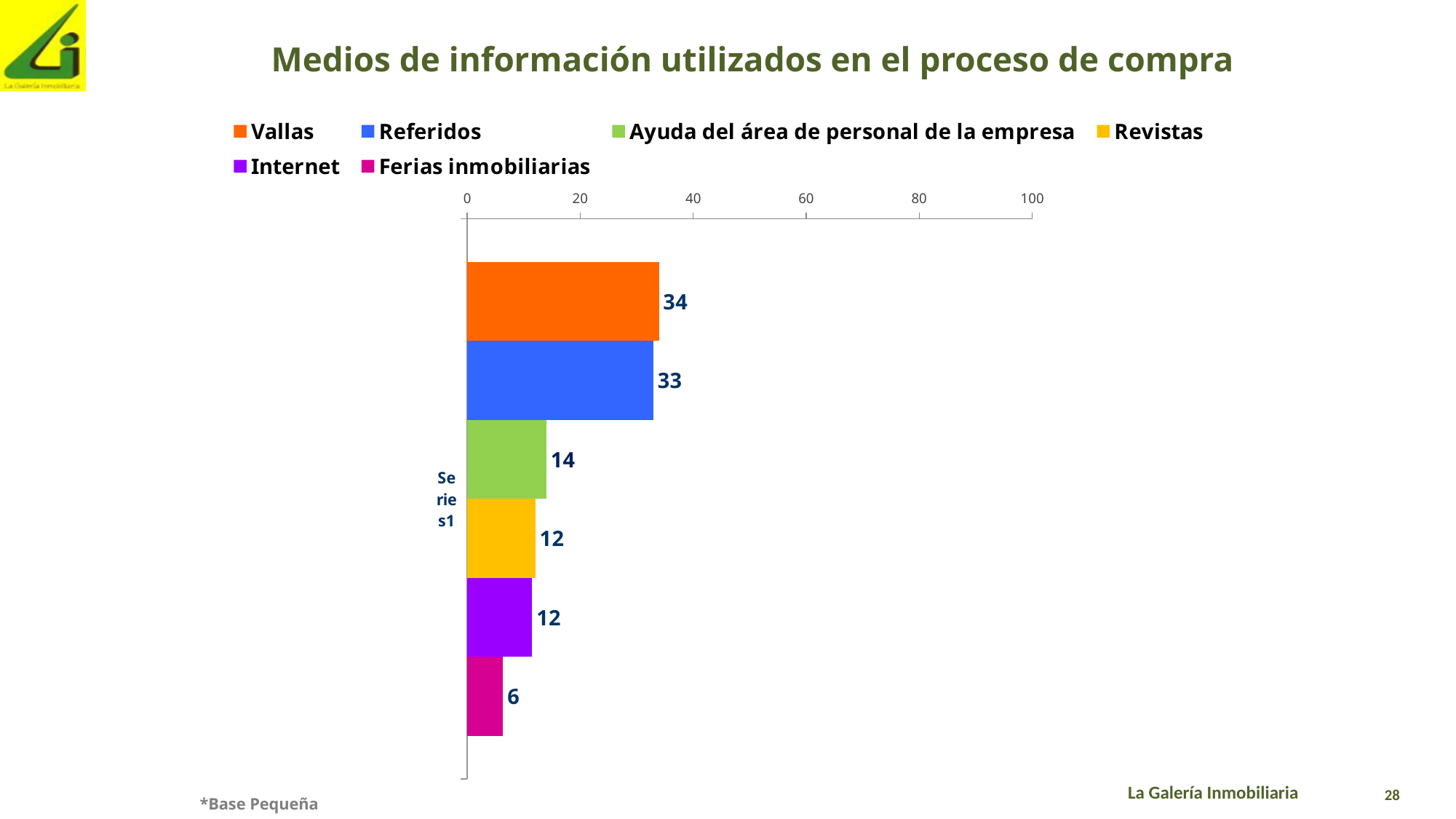
Which is larger, the value for Referidos or the value for Revistas? Referidos What kind of chart is shown on the slide? bar chart What is the difference between the values for Vallas and Ferias inmobiliarias? 28 What is the title of the chart? Medios de información utilizados en el proceso de compra What is the value for Referidos? 33 What is the value for Ayuda del área de personal de la empresa? 14 Which medium has the highest value? Vallas What is the value for Vallas? 34 How many series does the legend list? 6 What is the value for Ferias inmobiliarias? 6 Is the value for Internet greater or less than 20? less Which medium has the lowest value? Ferias inmobiliarias